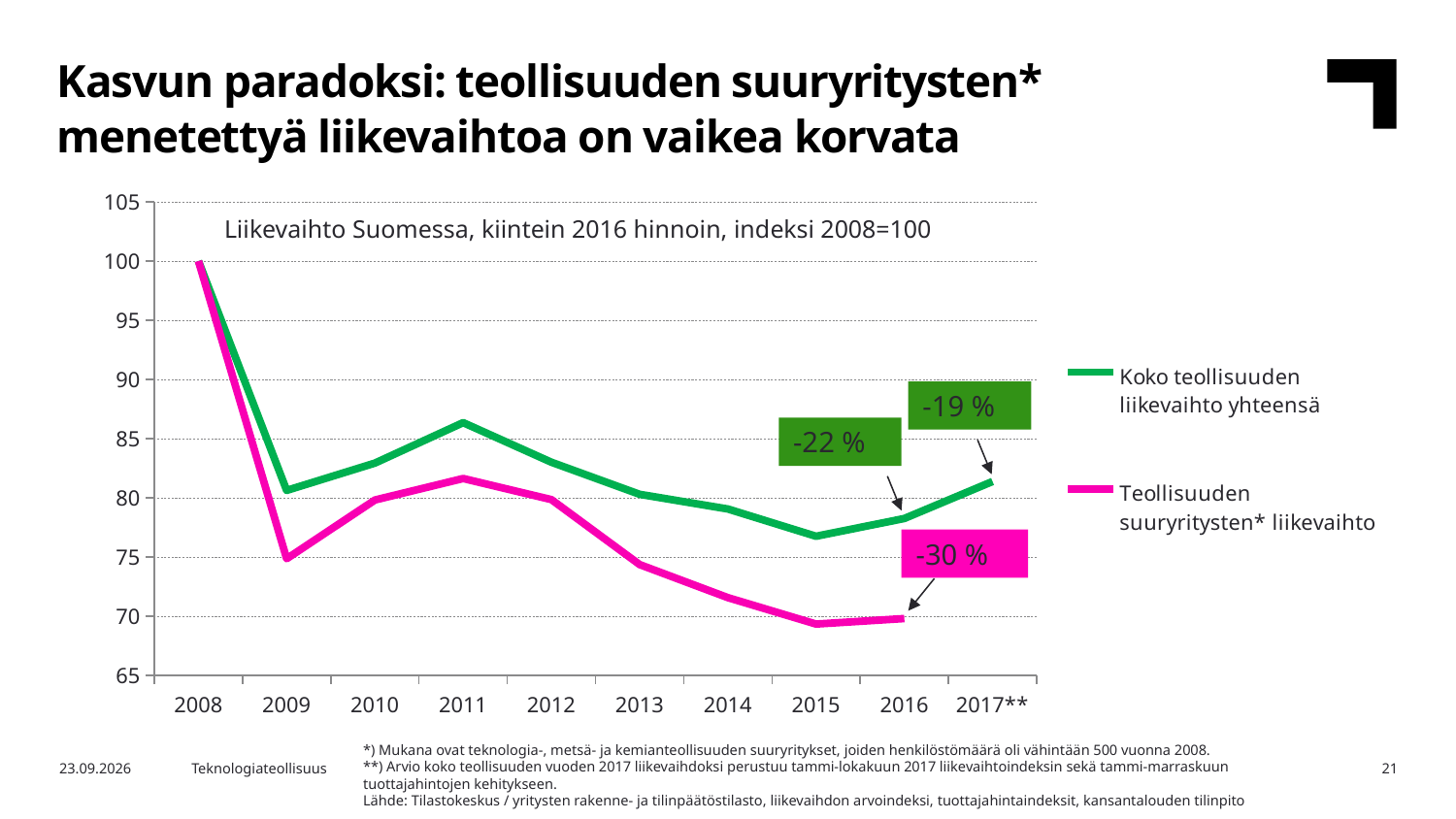
Which series is drawn in magenta? Teollisuuden suuryritysten* liikevaihto In which year is the Koko teollisuuden liikevaihto yhteensä series at its highest? 2008 Is the value for Koko teollisuuden liikevaihto yhteensä in 2011 greater or less than 85? greater What kind of chart is shown on the slide? line chart What percentage change is annotated on the Koko teollisuuden liikevaihto yhteensä line at 2017**? -19 % What is the title printed inside the chart area? Liikevaihto Suomessa, kiintein 2016 hinnoin, indeksi 2008=100 What percentage change is annotated on the Teollisuuden suuryritysten* liikevaihto line at 2016? -30 % Is the value for Koko teollisuuden liikevaihto yhteensä in 2015 greater or less than 80? less How many series does the legend list? 2 In 2015, which series has the higher value: Koko teollisuuden liikevaihto yhteensä or Teollisuuden suuryritysten* liikevaihto? Koko teollisuuden liikevaihto yhteensä What percentage change is annotated on the Koko teollisuuden liikevaihto yhteensä line at 2016? -22 % How many years are plotted along the x axis? 10